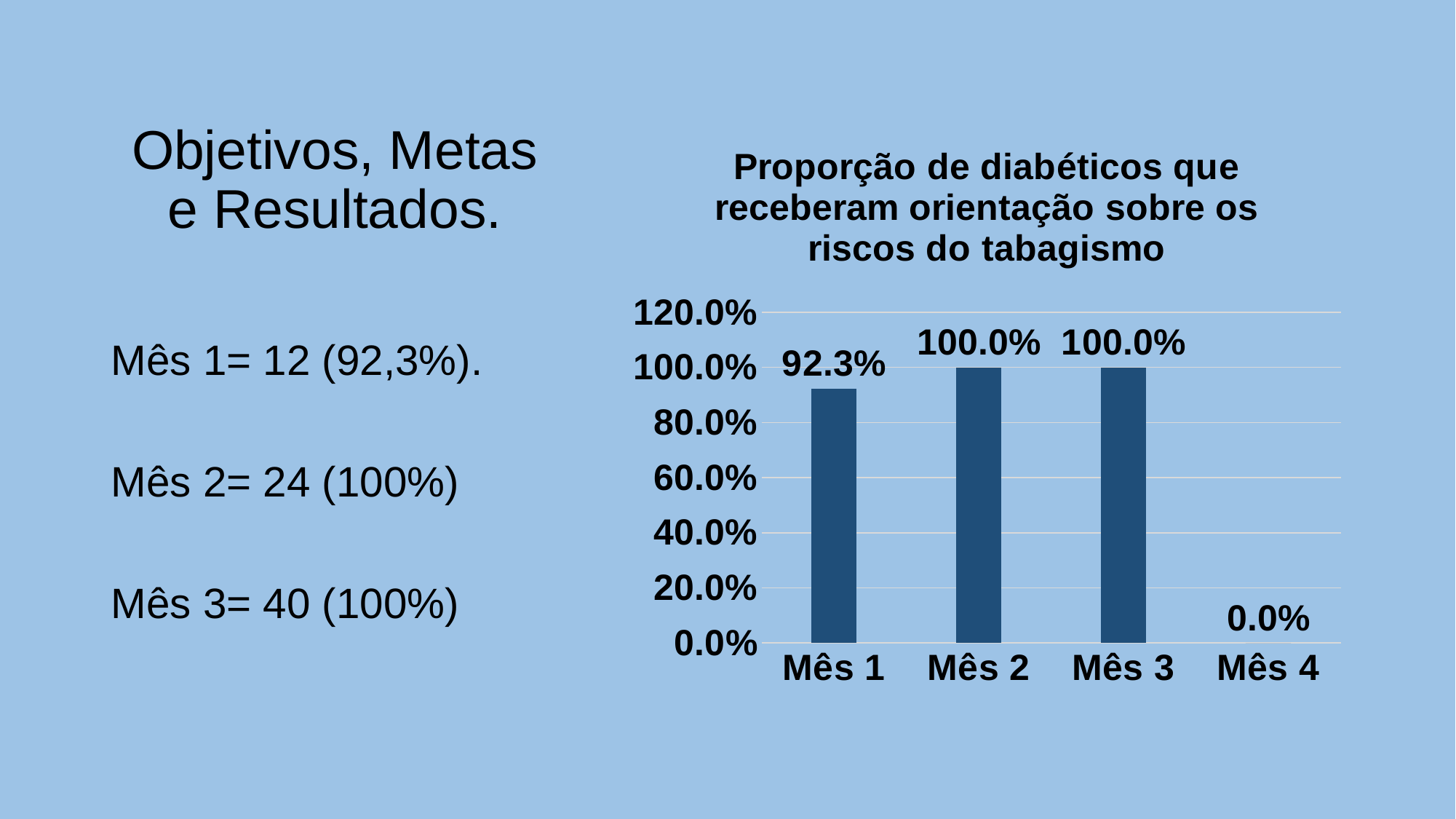
Which is larger, the value for Mês 1 or the value for Mês 3? Mês 3 What is the value for Mês 2? 100.0% What is the title of the chart? Proporção de diabéticos que receberam orientação sobre os riscos do tabagismo What is the value for Mês 4? 0.0% What is the difference between the values for Mês 2 and Mês 1? 7.7% What is the value for Mês 1? 92.3% What is the highest value shown on the y axis? 120.0% What kind of chart is shown on the slide? bar chart Do the values rise or fall from Mês 1 to Mês 2? rise Which category has the lowest value? Mês 4 How many categories are shown on the x axis? 4 Is the value for Mês 1 greater or less than 80.0%? greater